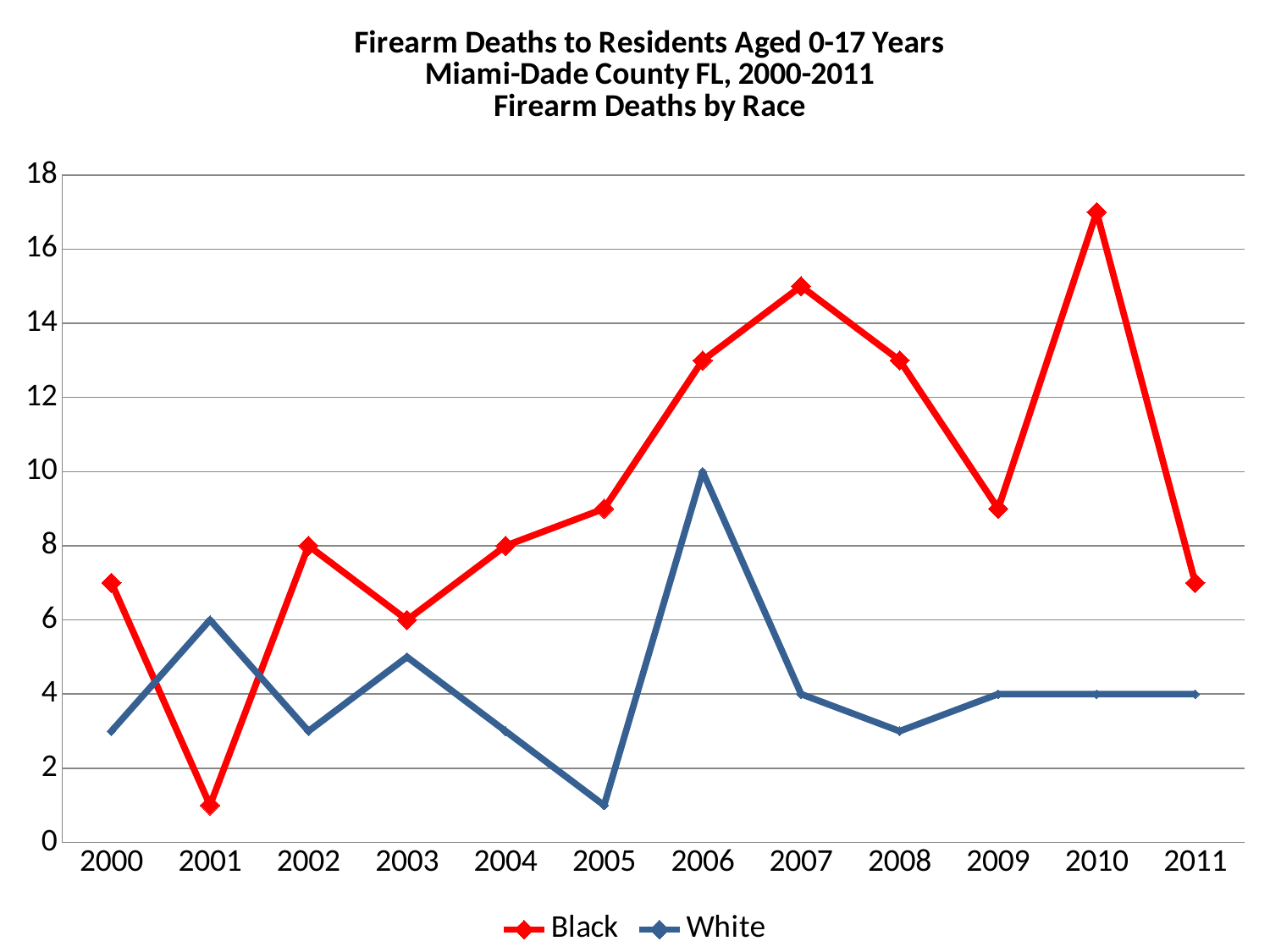
In which year is the Black series at its highest? 2010 What type of chart is shown on the slide? Line chart What is the value for Black in 2002? 8 Which series has the larger value in 2001, Black or White? White Is the value for Black in 2010 greater or less than 16? greater How many series does the legend list? 2 What is the value for White in 2006? 10 What is the difference between the White values in 2006 and 2007? 6 What is the value for White in 2011? 4 Is the value for Black in 2001 greater or less than 2? less How many years are plotted along the x axis? 12 In which year is the White series at its lowest? 2005